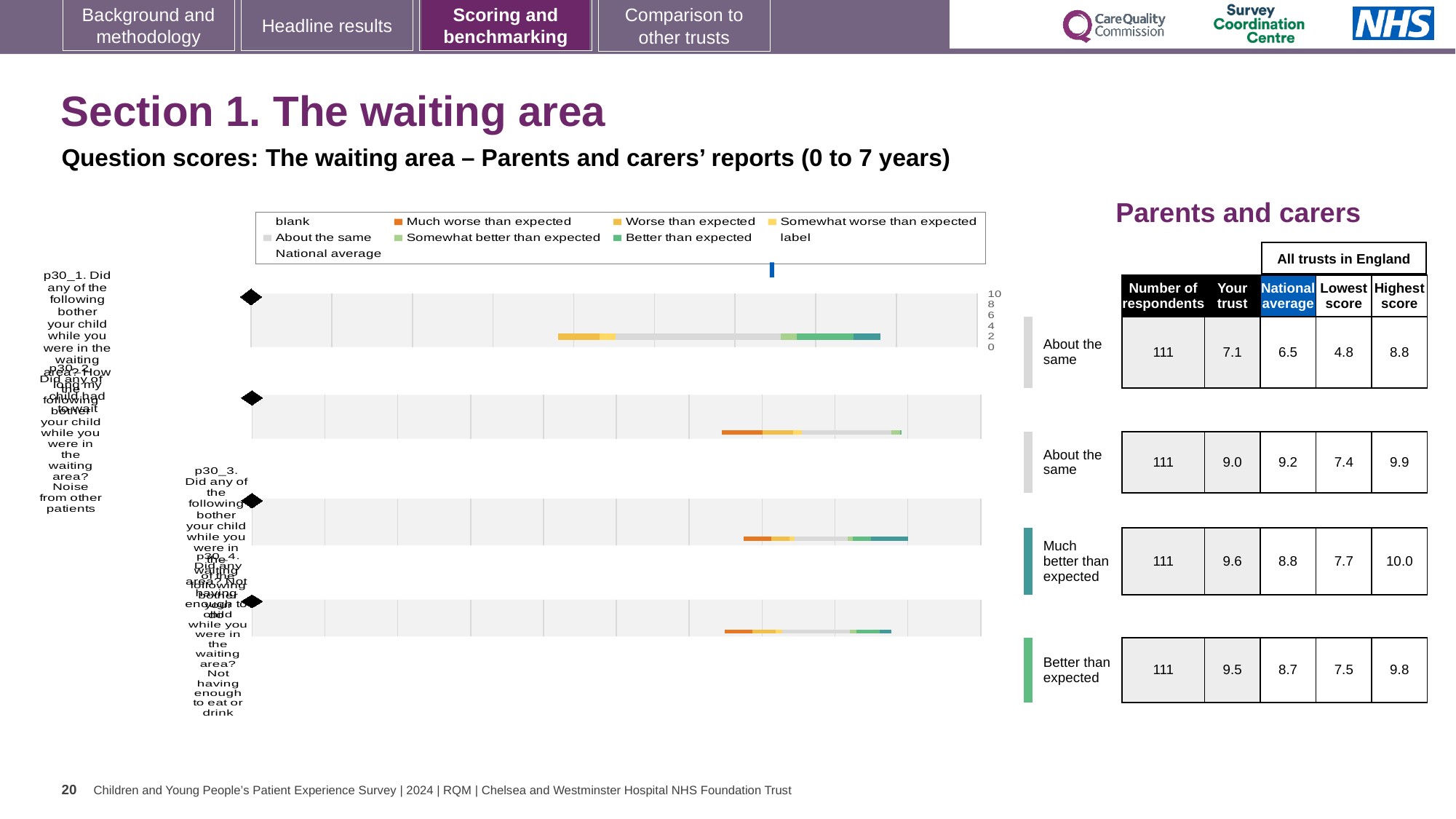
Which question has the lowest 'Your trust' score in the table beside the chart? p30_1 (How long my child had to wait) Which question has the highest 'Your trust' score in the table beside the chart? p30_3 (Not having enough to do) What does the dark blue marker in the chart legend represent? National average In the table beside the chart, what is the highest score for the third question (p30_3, not having enough to do)? 10.0 For the third question (p30_3), what is the difference between the 'Your trust' score and the national average? 0.8 In the table beside the chart, how many respondents are listed for each question? 111 What kind of chart is shown on the left of the slide? bar chart In the table beside the chart, what is the 'Your trust' score for the first question (p30_1, how long my child had to wait)? 7.1 In the table beside the chart, what is the national average for the first question (p30_1)? 6.5 For the second question (p30_2, noise from other patients), which is larger: the 'Your trust' score or the national average? National average How many question bars (p30_1 to p30_4) are plotted in the chart? 4 In the chart legend, which colour represents 'Much worse than expected'? orange